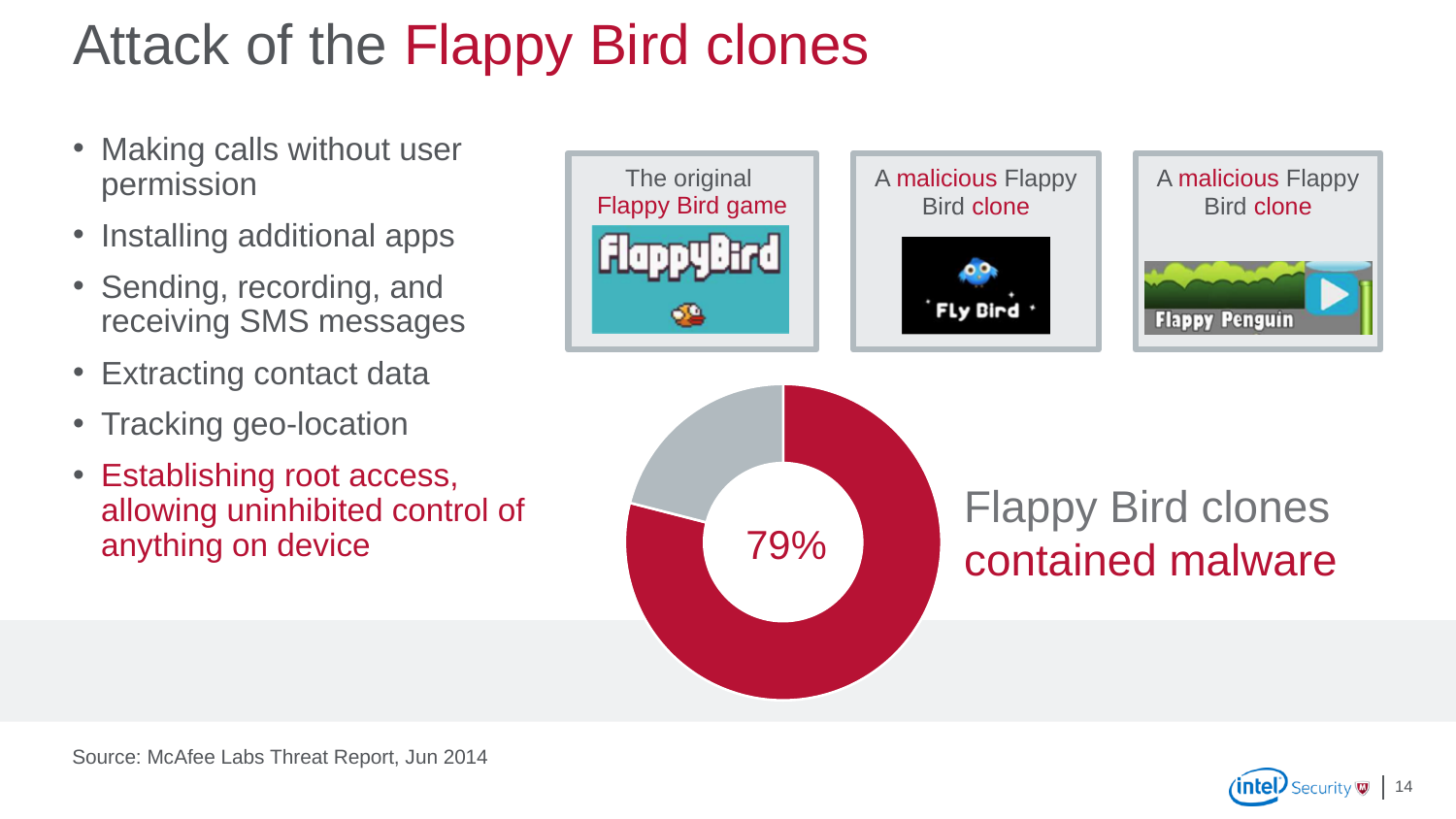
Is the share of Flappy Bird clones that contained malware greater or less than 50%? greater Which slice of the doughnut chart is larger, the red one or the grey one? the red one What percentage is printed in the centre of the doughnut chart? 79% What share of the doughnut chart does the grey slice represent? 21% What share of Flappy Bird clones contained malware, according to the chart? 79% How many slices does the doughnut chart have? 2 What kind of chart is shown on the slide? doughnut chart What colour is the slice representing Flappy Bird clones that contained malware? red What does the 79% slice of the doughnut chart represent? Flappy Bird clones that contained malware